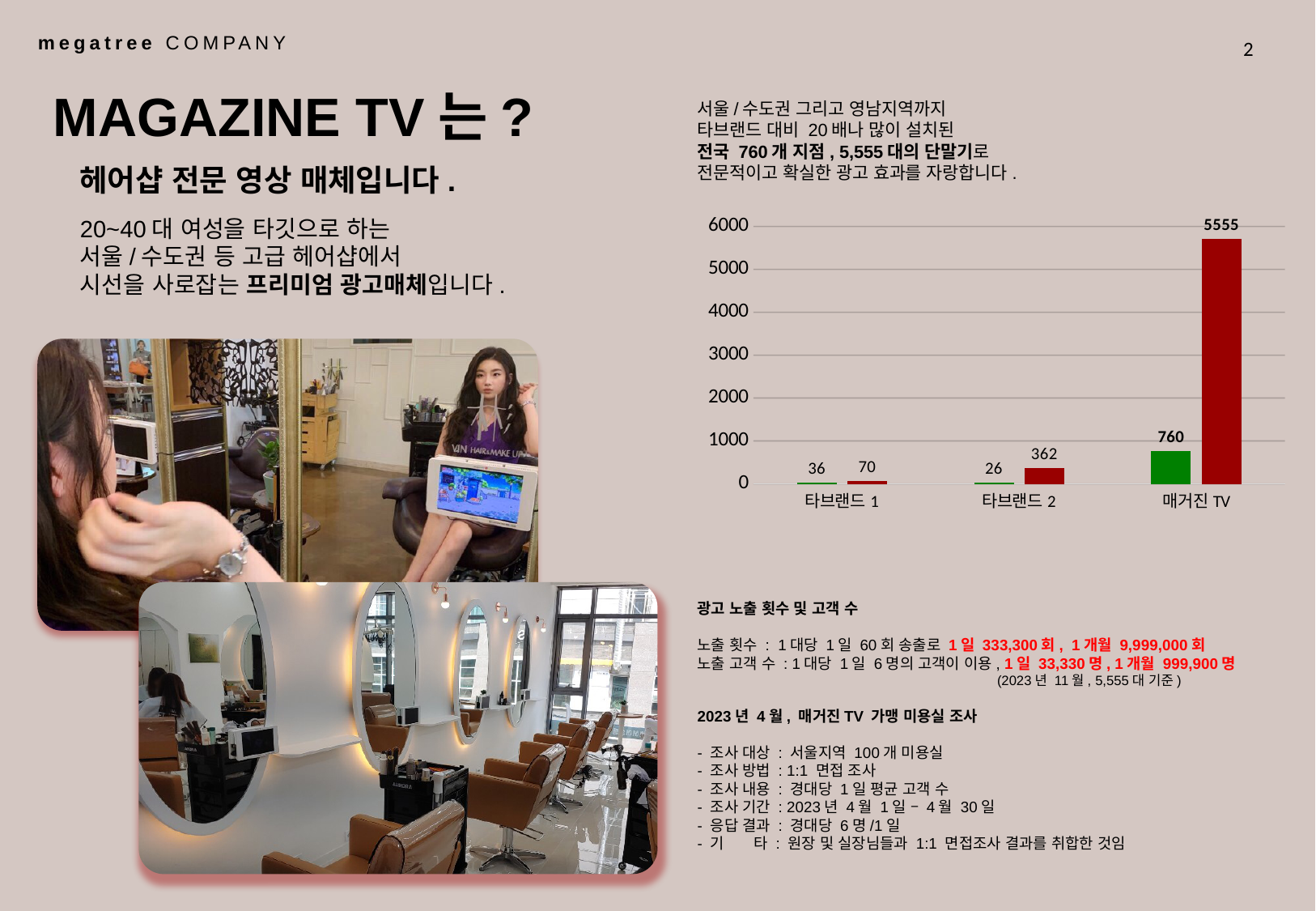
Which is larger: the dark red bar for 타브랜드 1 or the dark red bar for 타브랜드 2? 타브랜드 2 Is the dark red bar value for 매거진 TV greater or less than 5000? greater What is the value of the green bar for 매거진 TV? 760 Which category has the lowest green bar? 타브랜드 2 What type of chart is shown on the slide? bar chart What is the value of the green bar for 타브랜드 1? 36 What is the value of the dark red bar for 매거진 TV? 5555 How many categories are shown on the x axis of the chart? 3 Which category has the highest dark red bar? 매거진 TV What is the highest value shown on the chart's y axis? 6000 What is the difference between the dark red bar values for 매거진 TV and 타브랜드 2? 5193 What is the value of the dark red bar for 타브랜드 2? 362